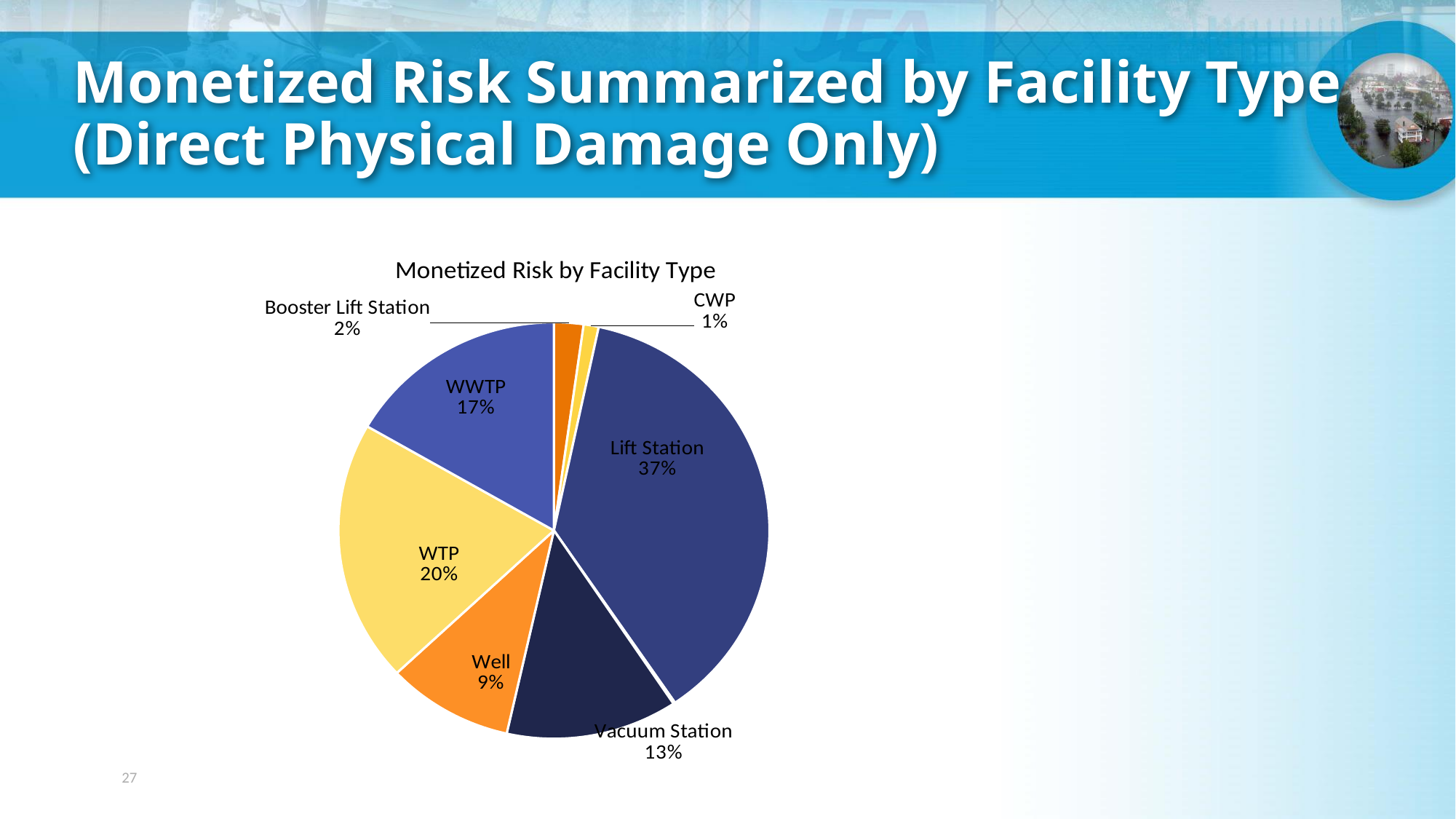
What share of monetized risk is attributed to Lift Station? 37% What percentage does the WTP slice represent? 20% Which facility type has the largest share of monetized risk? Lift Station Which has a larger share, Well or Vacuum Station? Vacuum Station What type of chart is shown on the slide? Pie chart What is the title of the chart? Monetized Risk by Facility Type How many facility types are shown in the pie chart? 7 What is the combined share of Booster Lift Station and CWP? 3% What is the value shown for Vacuum Station? 13% What is the difference in percentage points between WTP and WWTP? 3 What percentage is shown for CWP? 1%